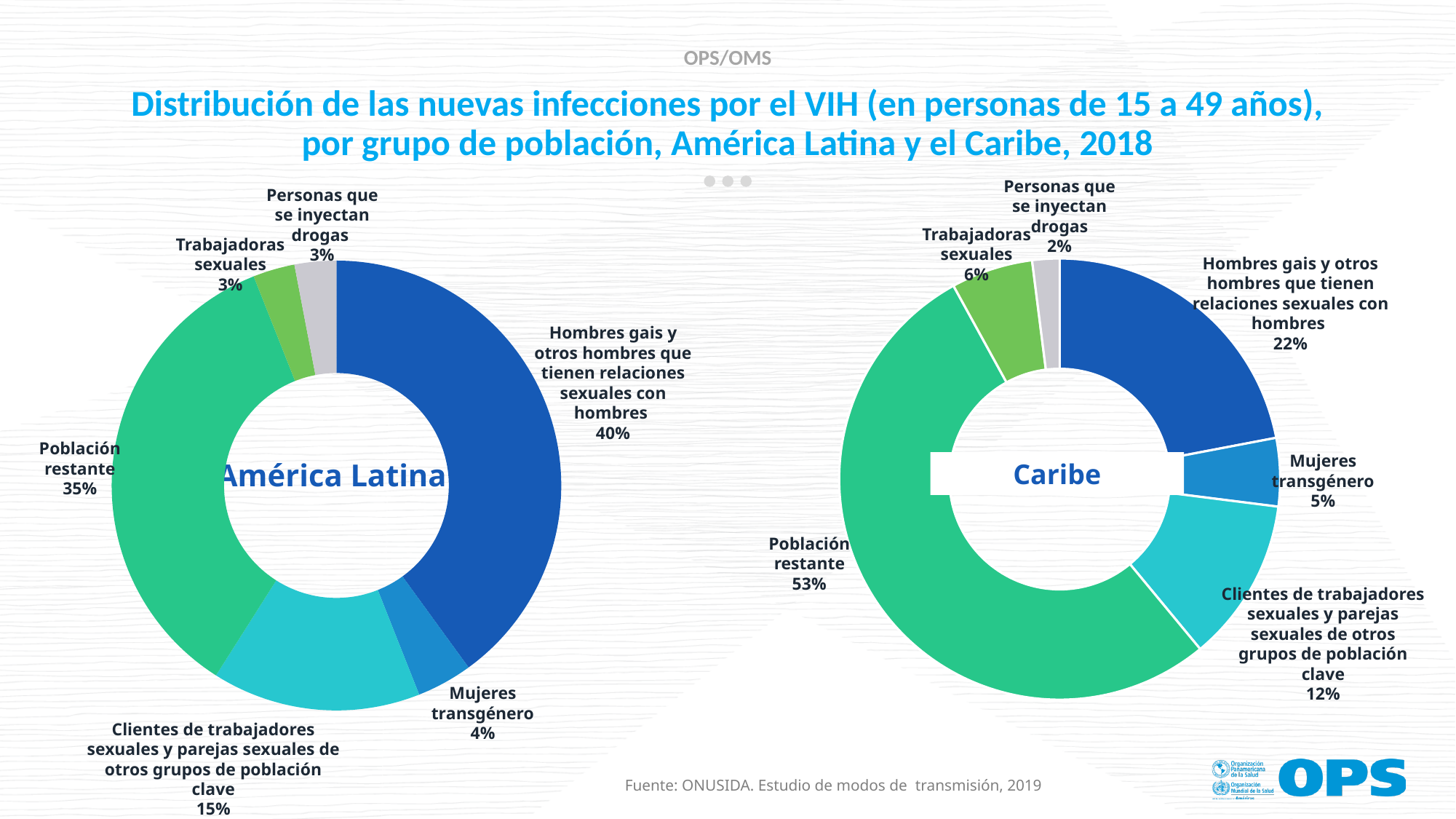
Which is larger: the 'Mujeres transgénero' share in the Caribe chart or in the América Latina chart? Caribe What is the source cited at the bottom of the slide? ONUSIDA. Estudio de modos de transmisión, 2019 In the Caribe chart, what is the combined share of 'Trabajadoras sexuales' and 'Personas que se inyectan drogas'? 8% In the América Latina chart, what share of new HIV infections is attributed to 'Hombres gais y otros hombres que tienen relaciones sexuales con hombres'? 40% How many population groups are shown in the Caribe chart? 6 What is the difference between the 'Población restante' share in the Caribe chart and in the América Latina chart? 18 percentage points In the Caribe chart, what share of new HIV infections is attributed to 'Población restante'? 53% In the América Latina chart, what is the value for 'Clientes de trabajadores sexuales y parejas sexuales de otros grupos de población clave'? 15% In the América Latina chart, which population group has the largest share? Hombres gais y otros hombres que tienen relaciones sexuales con hombres In the Caribe chart, which population group has the smallest share? Personas que se inyectan drogas In the Caribe chart, what is the value for 'Trabajadoras sexuales'? 6% What type of chart is used for América Latina? Doughnut (pie) chart